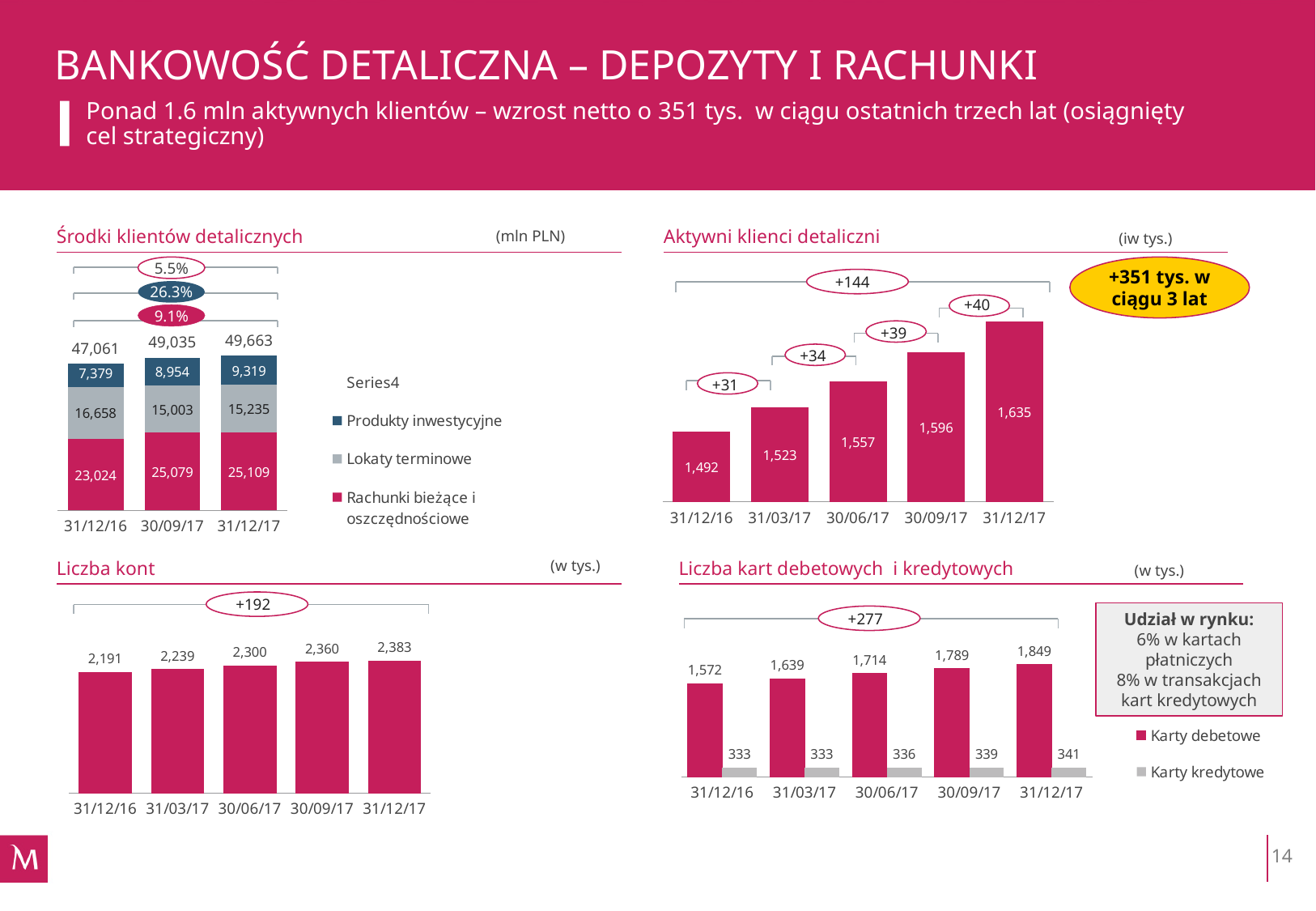
In the 'Środki klientów detalicznych' chart, what is the difference between Produkty inwestycyjne for 31/12/17 and 31/12/16? 1,940 In the 'Środki klientów detalicznych' chart, what is the total of the stacked bar for 31/12/17? 49,663 In the 'Aktywni klienci detaliczni' chart, what is the value for 31/12/17? 1,635 In the 'Aktywni klienci detaliczni' chart, do the values rise or fall from 31/12/16 to 31/12/17? rise In the 'Liczba kart debetowych i kredytowych' chart, which is larger: Karty debetowe for 31/03/17 or Karty debetowe for 30/06/17? Karty debetowe for 30/06/17 In the 'Liczba kart debetowych i kredytowych' chart, how many series does the legend list? 2 In the 'Aktywni klienci detaliczni' chart, how many bars are plotted? 5 In the 'Liczba kont' chart, what is the difference between the values for 31/12/17 and 31/12/16? 192 In the 'Środki klientów detalicznych' chart, what is the value of Lokaty terminowe for 30/09/17? 15,003 In the 'Środki klientów detalicznych' chart, which date has the lowest total? 31/12/16 In the 'Liczba kart debetowych i kredytowych' chart, what is the value of Karty kredytowe for 30/09/17? 339 In the 'Liczba kont' chart, what is the value for 30/06/17? 2,300